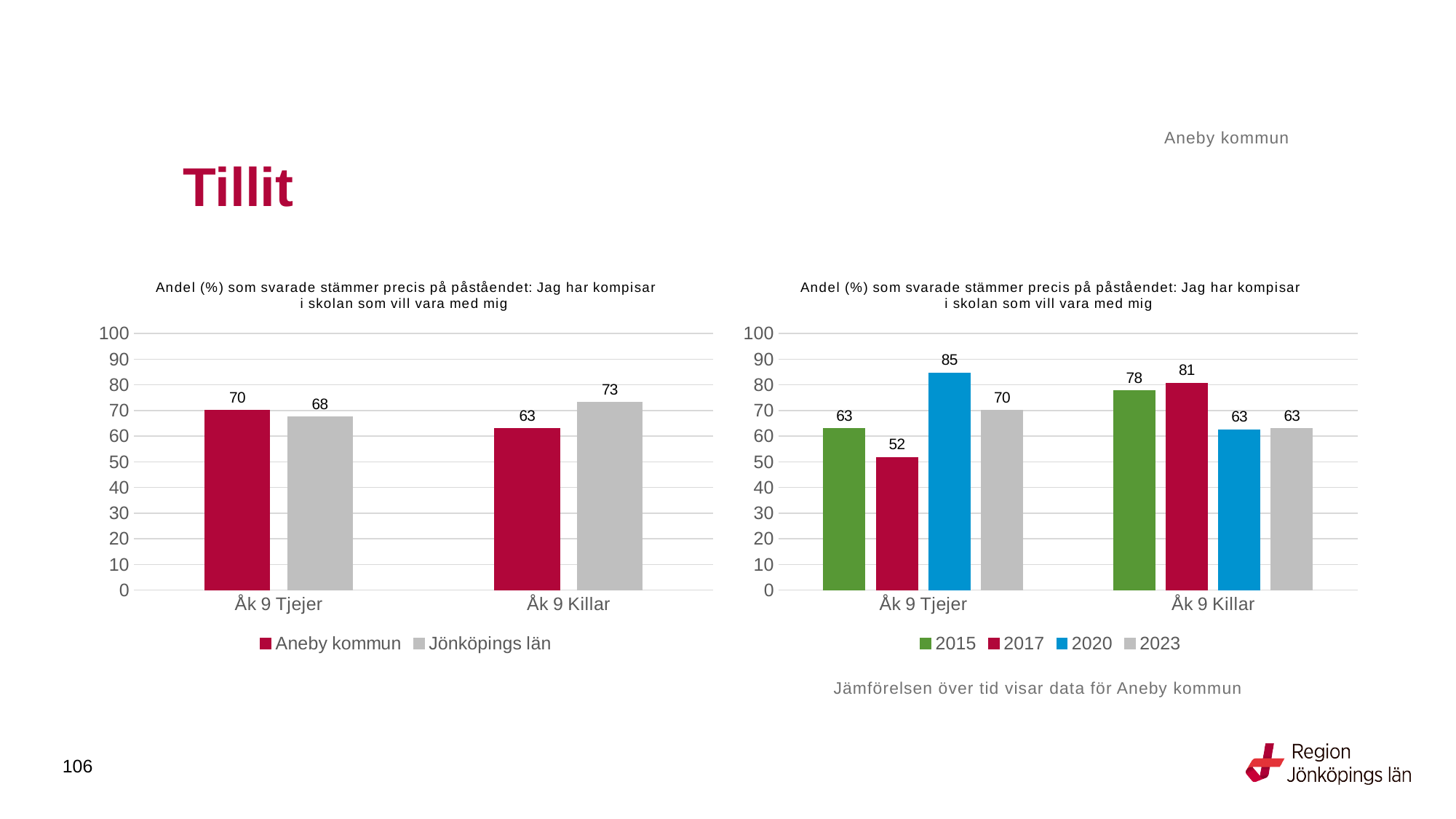
In the right chart, which year has the lowest value for Åk 9 Tjejer? 2017 In the right chart, which year has the highest value for Åk 9 Killar? 2017 In the left chart, what is the value for Aneby kommun for Åk 9 Tjejer? 70 In the right chart, what is the value for 2020 for Åk 9 Tjejer? 85 In the left chart, which is larger for Åk 9 Tjejer: Aneby kommun or Jönköpings län? Aneby kommun What kind of chart is the right chart? Bar chart In the right chart, what is the difference between the 2020 and 2017 values for Åk 9 Tjejer? 33 In the right chart, what is the value for 2017 for Åk 9 Killar? 81 In the left chart, how many series does the legend list? 2 In the left chart, what is the value for Jönköpings län for Åk 9 Killar? 73 In the left chart, what is the difference between Jönköpings län and Aneby kommun for Åk 9 Killar? 10 In the right chart, how many series does the legend list? 4